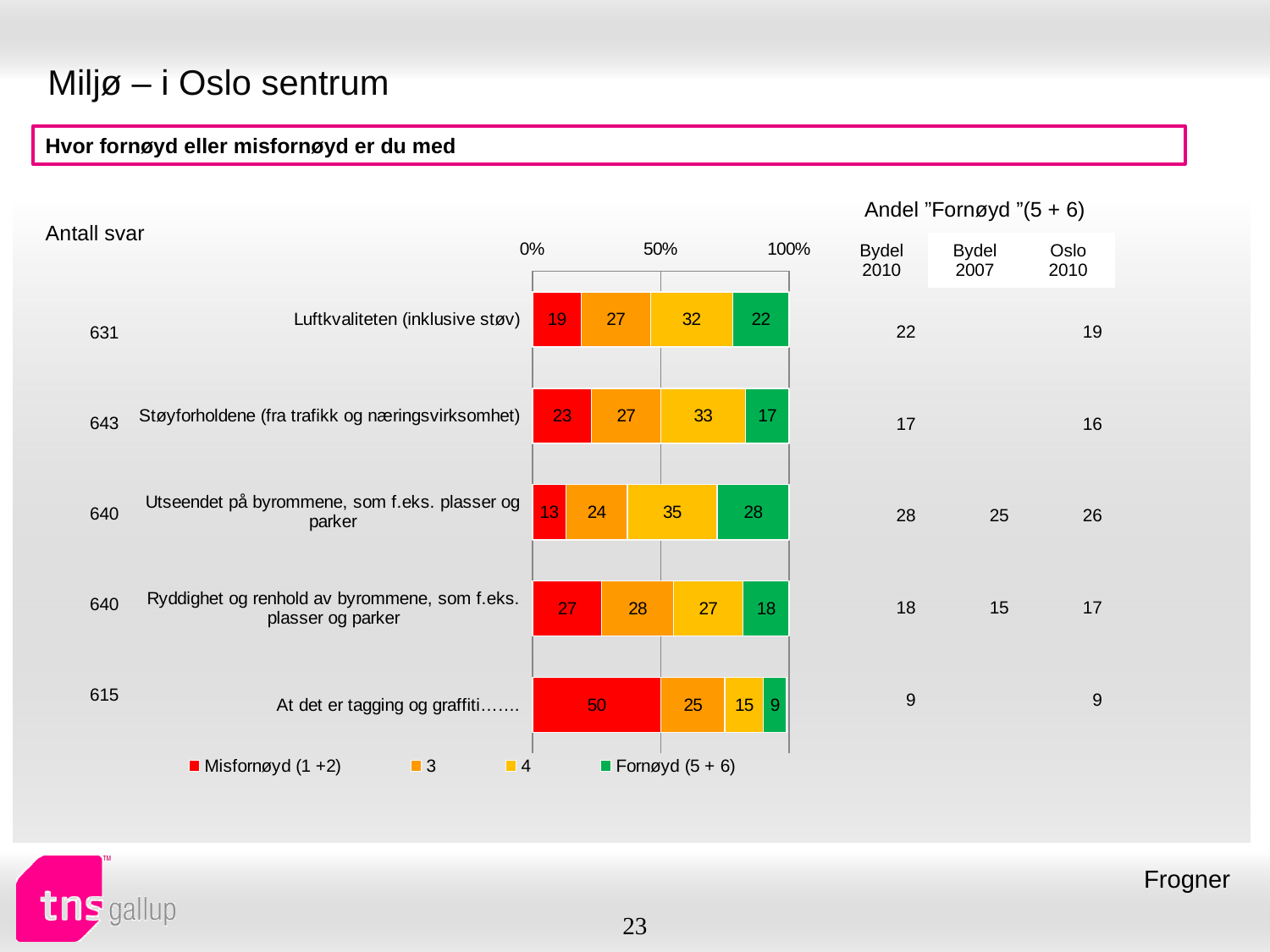
How many series does the legend list? 4 What is the total of the stacked bar for "Støyforholdene (fra trafikk og næringsvirksomhet)"? 100 What is the Misfornøyd (1 +2) value for "At det er tagging og graffiti…"? 50 What kind of chart is shown on the slide? Stacked bar chart Which has a larger Misfornøyd (1 +2) value: "Ryddighet og renhold av byrommene, som f.eks. plasser og parker" or "Luftkvaliteten (inklusive støv)"? Ryddighet og renhold av byrommene, som f.eks. plasser og parker Which category has the highest Misfornøyd (1 +2) value? At det er tagging og graffiti… Which category has the lowest Fornøyd (5 + 6) value? At det er tagging og graffiti… How many categories are shown in the chart? 5 What is the value of series "3" for "Luftkvaliteten (inklusive støv)"? 27 What is the Fornøyd (5 + 6) value for "Utseendet på byrommene, som f.eks. plasser og parker"? 28 What is the value of series "4" for "Støyforholdene (fra trafikk og næringsvirksomhet)"? 33 What is the difference between the Fornøyd (5 + 6) values for "Utseendet på byrommene, som f.eks. plasser og parker" and "Luftkvaliteten (inklusive støv)"? 6